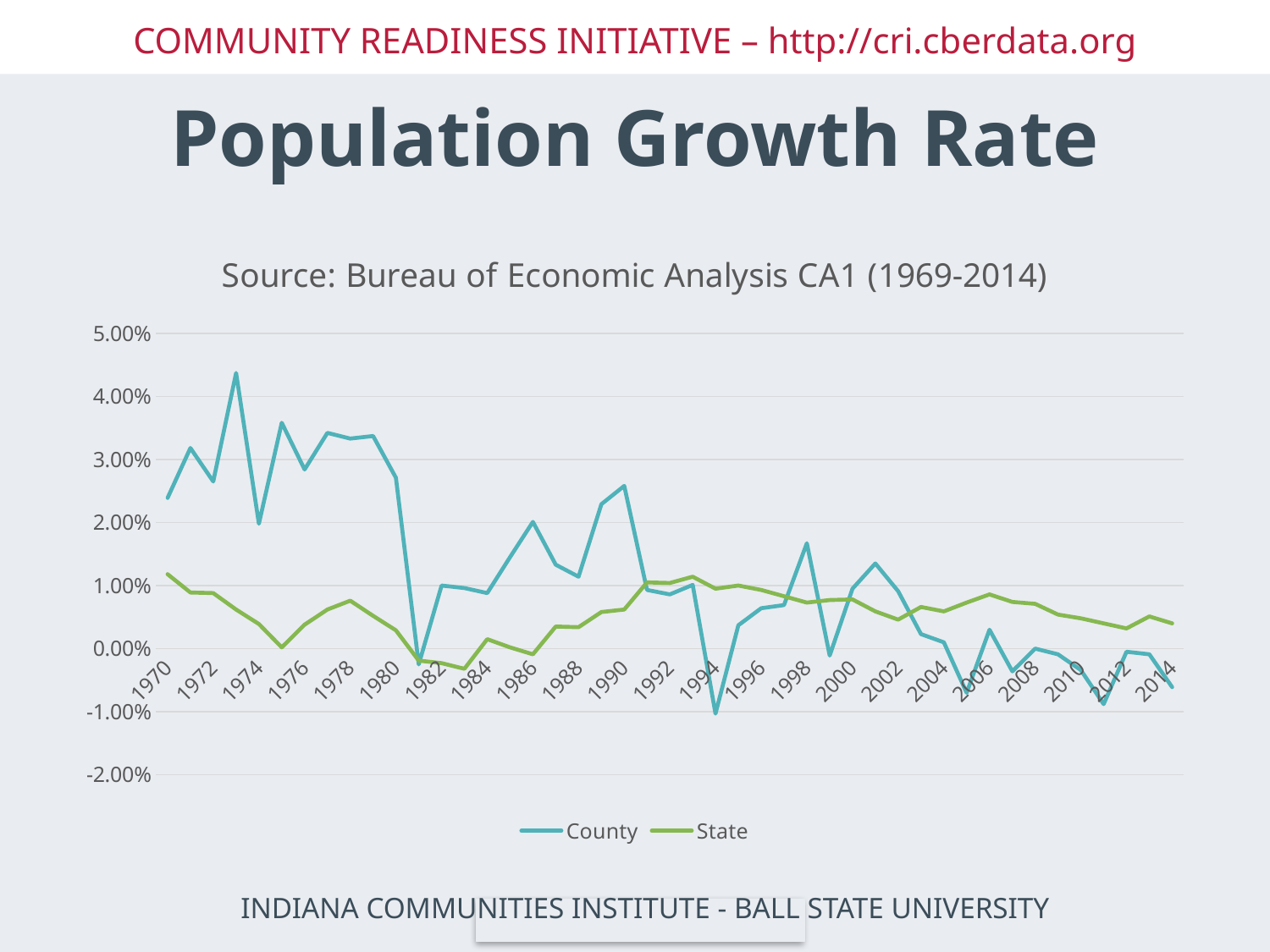
In 2010, which series has the higher value, County or State? State Overall, do the County values rise or fall from 1970 to 2014? fall Is the State value in 1990 greater or less than 1.00%? less Is the County value in 1990 greater or less than 2.00%? greater In 1973, which series has the higher value, County or State? County Is the State value in 2014 greater or less than 1.00%? less What kind of chart is shown on the slide? line chart How many series does the legend list? 2 What are the two series named in the legend? County and State What source is cited in the chart title? Bureau of Economic Analysis CA1 (1969-2014)